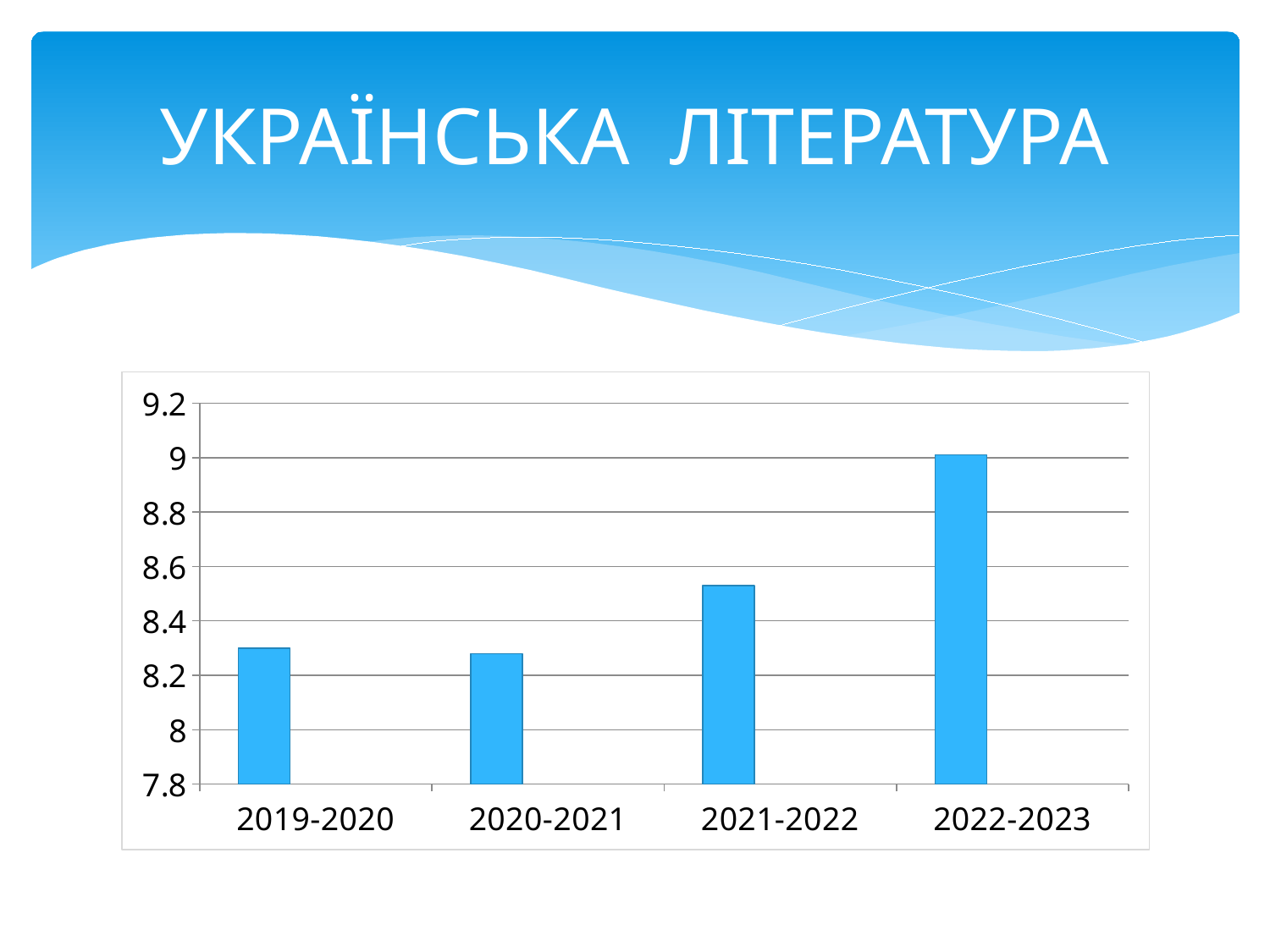
Is the value for 2021-2022 greater or less than 8.4? greater Is the value for 2020-2021 greater or less than 8.2? greater Which is larger, the value for 2022-2023 or the value for 2019-2020? 2022-2023 What kind of chart is shown on the slide? bar chart Is the value for 2019-2020 greater or less than 8.4? less Which school year has the highest value in the chart? 2022-2023 What is the title shown at the top of the slide above the chart? УКРАЇНСЬКА ЛІТЕРАТУРА How many categories (school years) are shown on the x axis of the chart? 4 Do the values rise or fall from 2020-2021 to 2022-2023? rise Which is larger, the value for 2021-2022 or the value for 2020-2021? 2021-2022